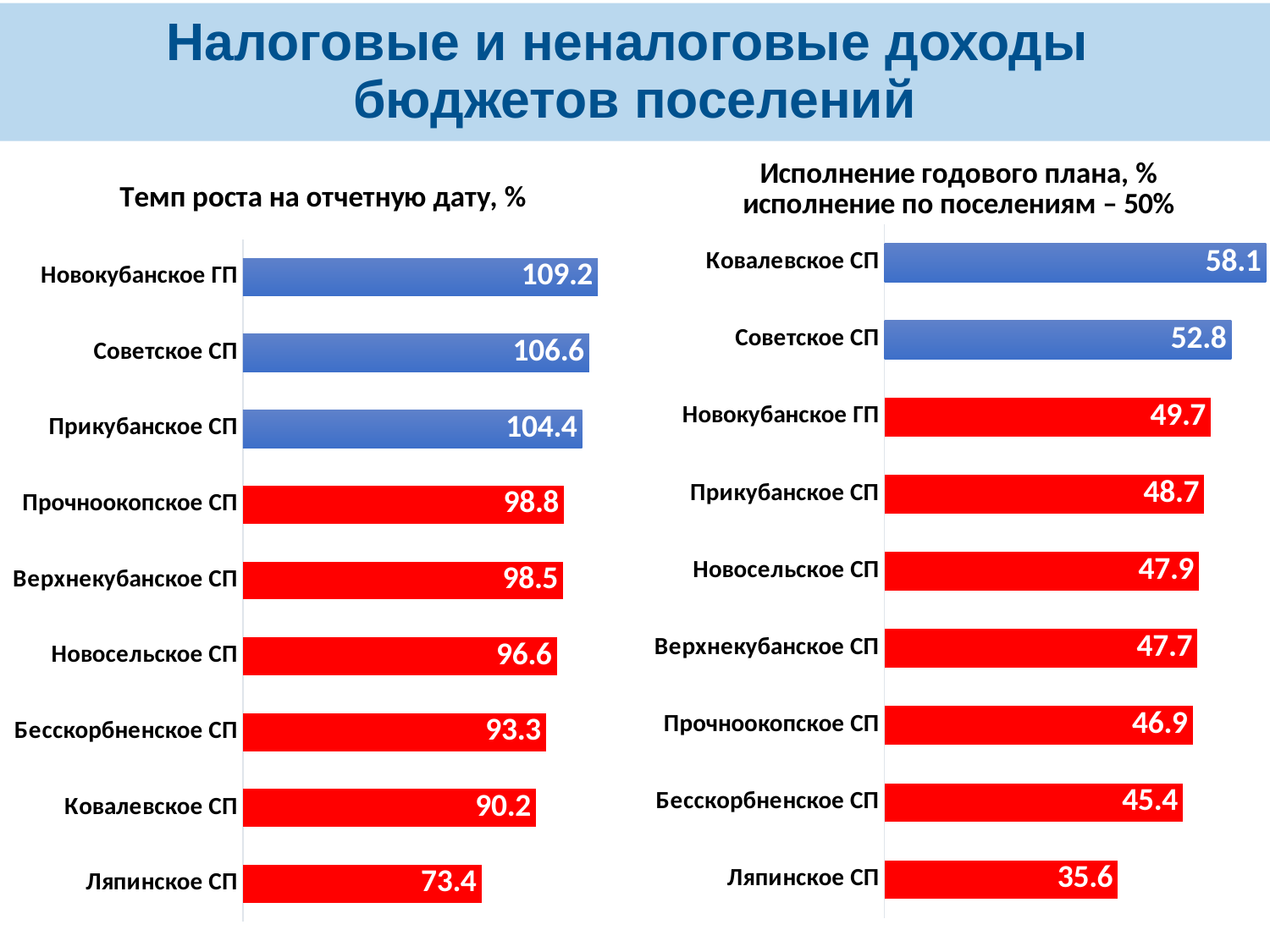
In the right chart 'Исполнение годового плана, %', what is the value for Прикубанское СП? 48.7 In the left chart 'Темп роста на отчетную дату, %', which category has the highest value? Новокубанское ГП In the left chart 'Темп роста на отчетную дату, %', what is the difference between Новокубанское ГП and Ляпинское СП? 35.8 In the left chart 'Темп роста на отчетную дату, %', how many categories are shown? 9 In the left chart 'Темп роста на отчетную дату, %', what is the value for Советское СП? 106.6 In the right chart 'Исполнение годового плана, %', which category has the lowest value? Ляпинское СП In the right chart 'Исполнение годового плана, %', which is larger: Советское СП or Новокубанское ГП? Советское СП In the right chart 'Исполнение годового плана, %', which category has the highest value? Ковалевское СП In the right chart 'Исполнение годового плана, %', what is the difference between Ковалевское СП and Советское СП? 5.3 What type of chart is the left chart 'Темп роста на отчетную дату, %'? bar chart In the right chart 'Исполнение годового плана, %', how many bars are coloured blue? 2 In the left chart 'Темп роста на отчетную дату, %', which category has the lowest value? Ляпинское СП